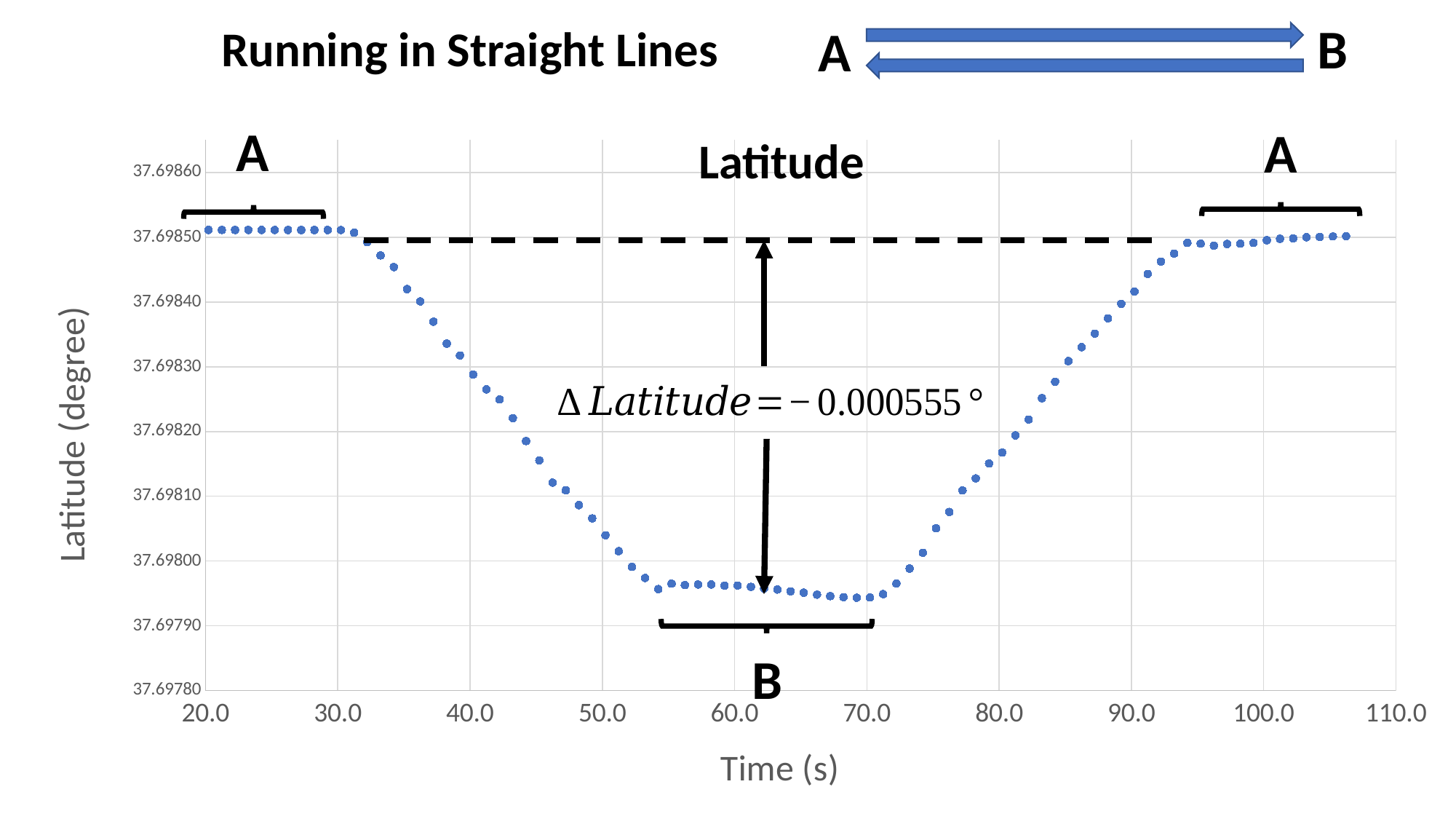
What is the label of the x axis of the chart? Time (s) Do the latitude values rise or fall as time goes from 30 s to 55 s? fall What kind of chart is shown on the slide? scatter chart Is the latitude value at 35 s greater or less than 37.69840? greater What value of ΔLatitude is annotated on the chart? −0.000555° Which labeled region of the chart, A or B, has the lower latitude values? B Is the latitude value at 60 s greater or less than 37.69800? less Do the latitude values rise or fall as time goes from 70 s to 95 s? rise Is the latitude value at 50 s greater or less than 37.69810? less What is the title of the chart? Latitude Which is larger, the latitude value at 25 s or at 60 s? 25 s